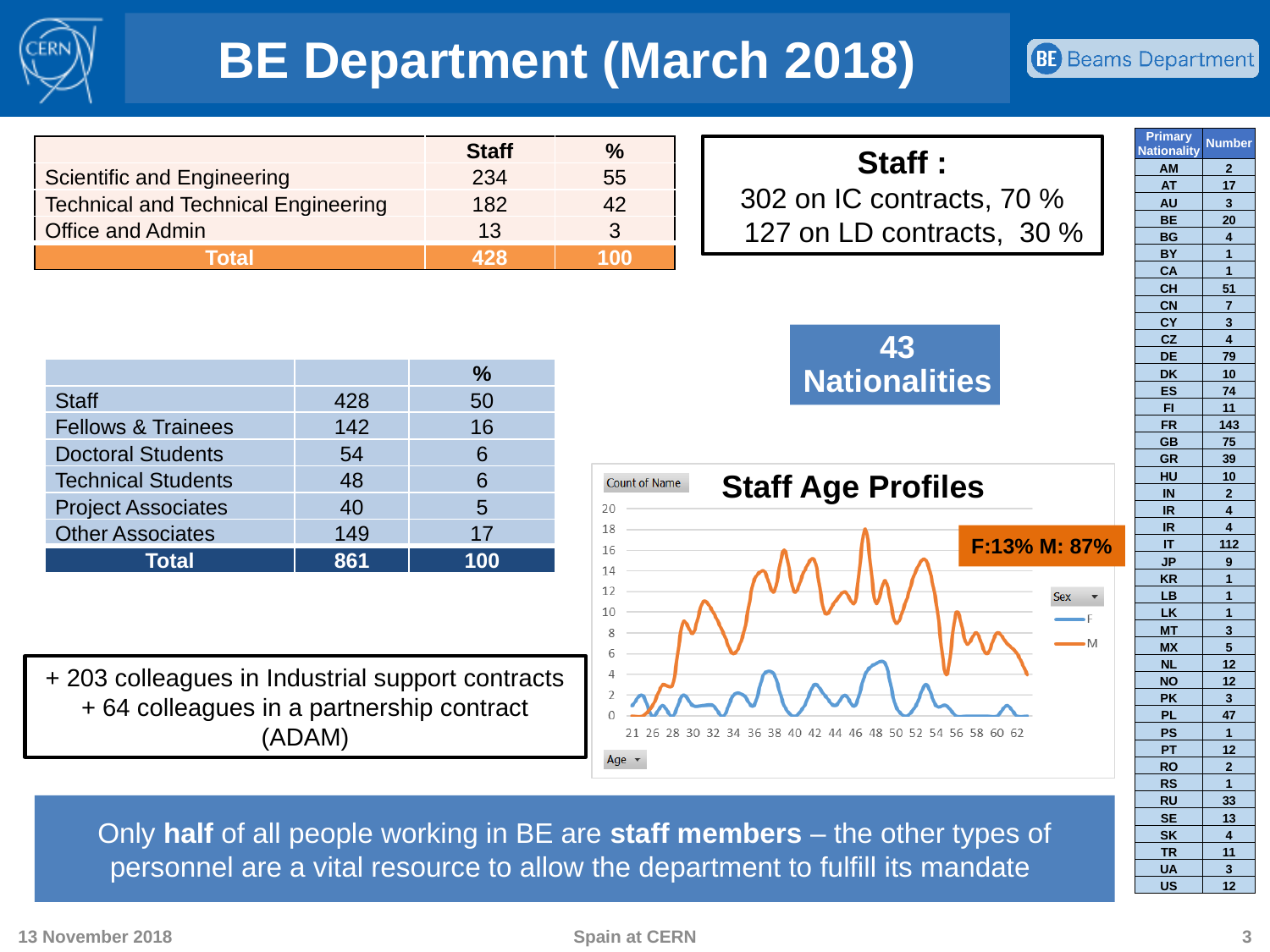
What is the highest tick value shown on the y axis of the Staff Age Profiles chart? 20 What kind of chart is the Staff Age Profiles chart? line chart In the Staff Age Profiles chart, is the value of the M series at age 21 greater or less than 4? less How many series does the legend of the Staff Age Profiles chart list? 2 In the Staff Age Profiles chart, is the highest value of the M series greater or less than 16? greater In the Staff Age Profiles chart, which series is drawn in orange? M In the Staff Age Profiles chart, which series has the lower values across the age range, F or M? F What is the title of the line chart on the slide? Staff Age Profiles In the Staff Age Profiles chart, is the value of the M series at age 62 greater or less than 8? less In the Staff Age Profiles chart, which series reaches the highest value? M What is the last age label shown on the x axis of the Staff Age Profiles chart? 62